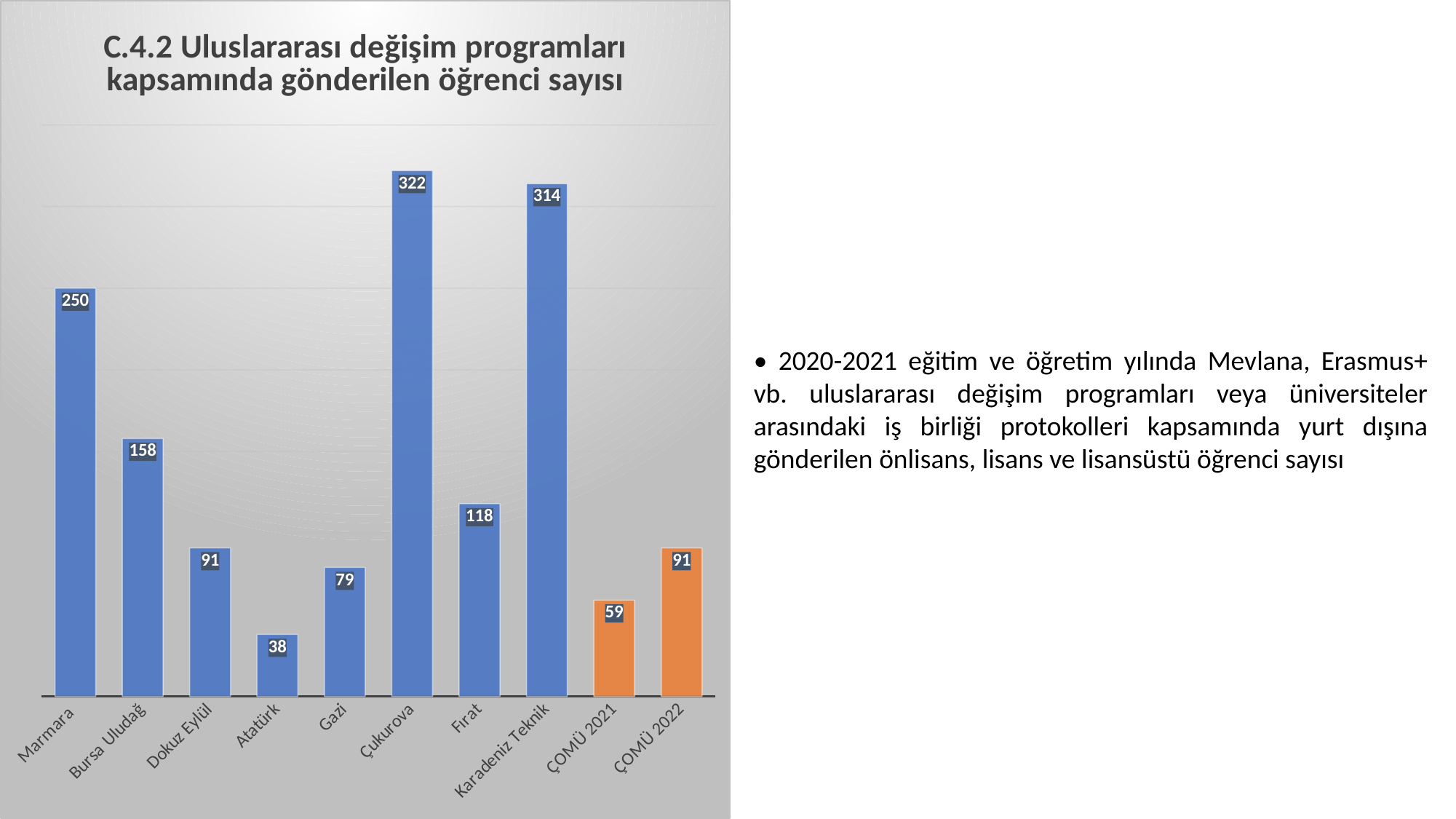
What is the value for Çukurova? 322 What is the title of the chart? C.4.2 Uluslararası değişim programları kapsamında gönderilen öğrenci sayısı What is the difference between the values for ÇOMÜ 2022 and ÇOMÜ 2021? 32 What is the difference between the values for Çukurova and Karadeniz Teknik? 8 What is the value for Atatürk? 38 Which is larger, the value for Bursa Uludağ or the value for Fırat? Bursa Uludağ Which category has the lowest value? Atatürk What kind of chart is this? Bar chart What is the value for ÇOMÜ 2021? 59 What is the value for Marmara? 250 How many categories are shown on the x axis? 10 Which category has the highest value? Çukurova